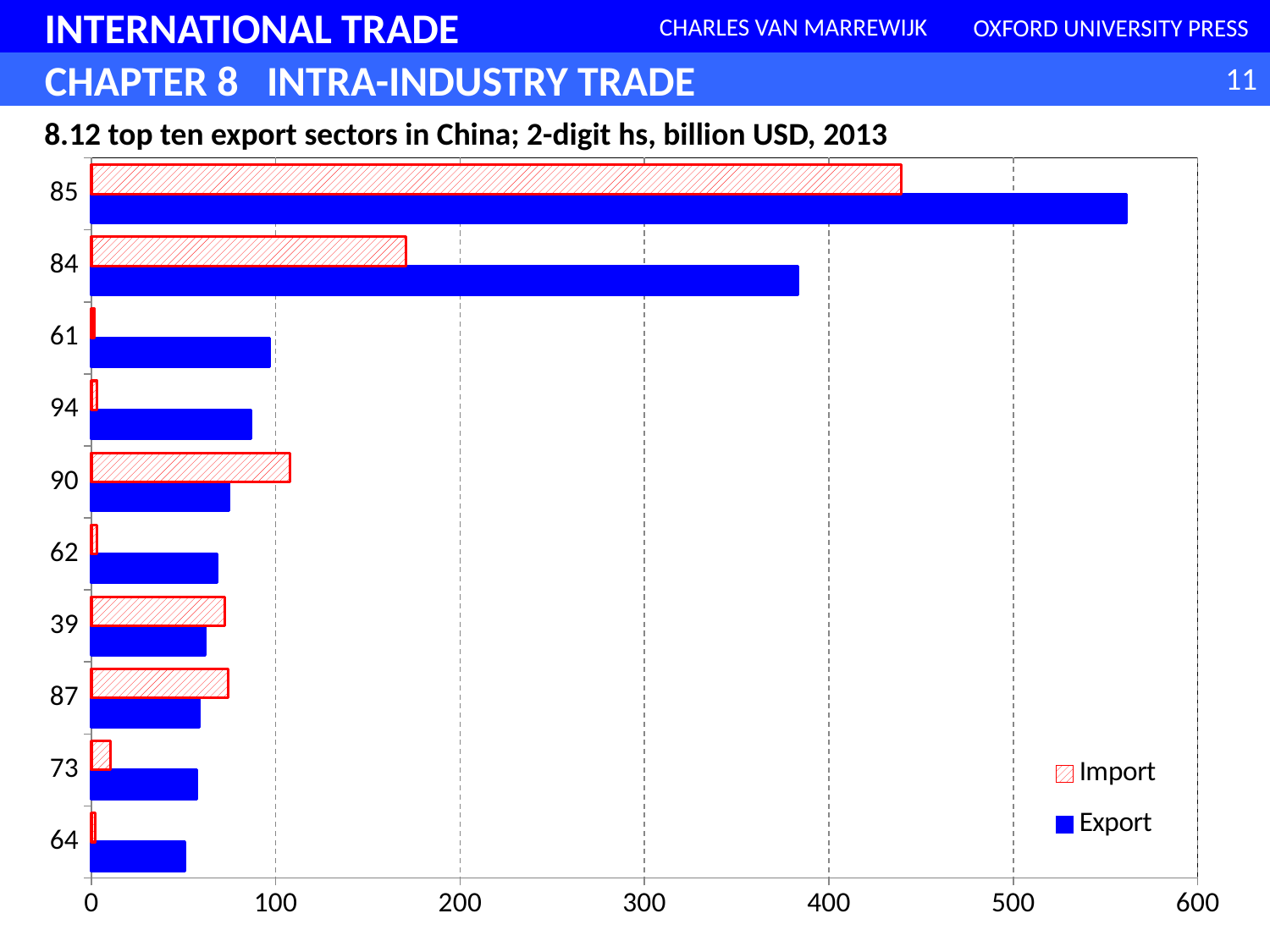
Which sector has the highest Export value? 85 What is the title of the chart? 8.12 top ten export sectors in China; 2-digit hs, billion USD, 2013 Which sector has the highest Import value? 85 Is the Import value for sector 84 greater or less than 200? less For sector 90, which is larger, Import or Export? Import How many sectors (categories) are shown on the chart? 10 Which sector has the lowest Export value? 64 What kind of chart is shown on the slide? bar chart Is the Export value for sector 64 greater or less than 100? less Is the Export value for sector 84 greater or less than 300? greater How many series does the legend list? 2